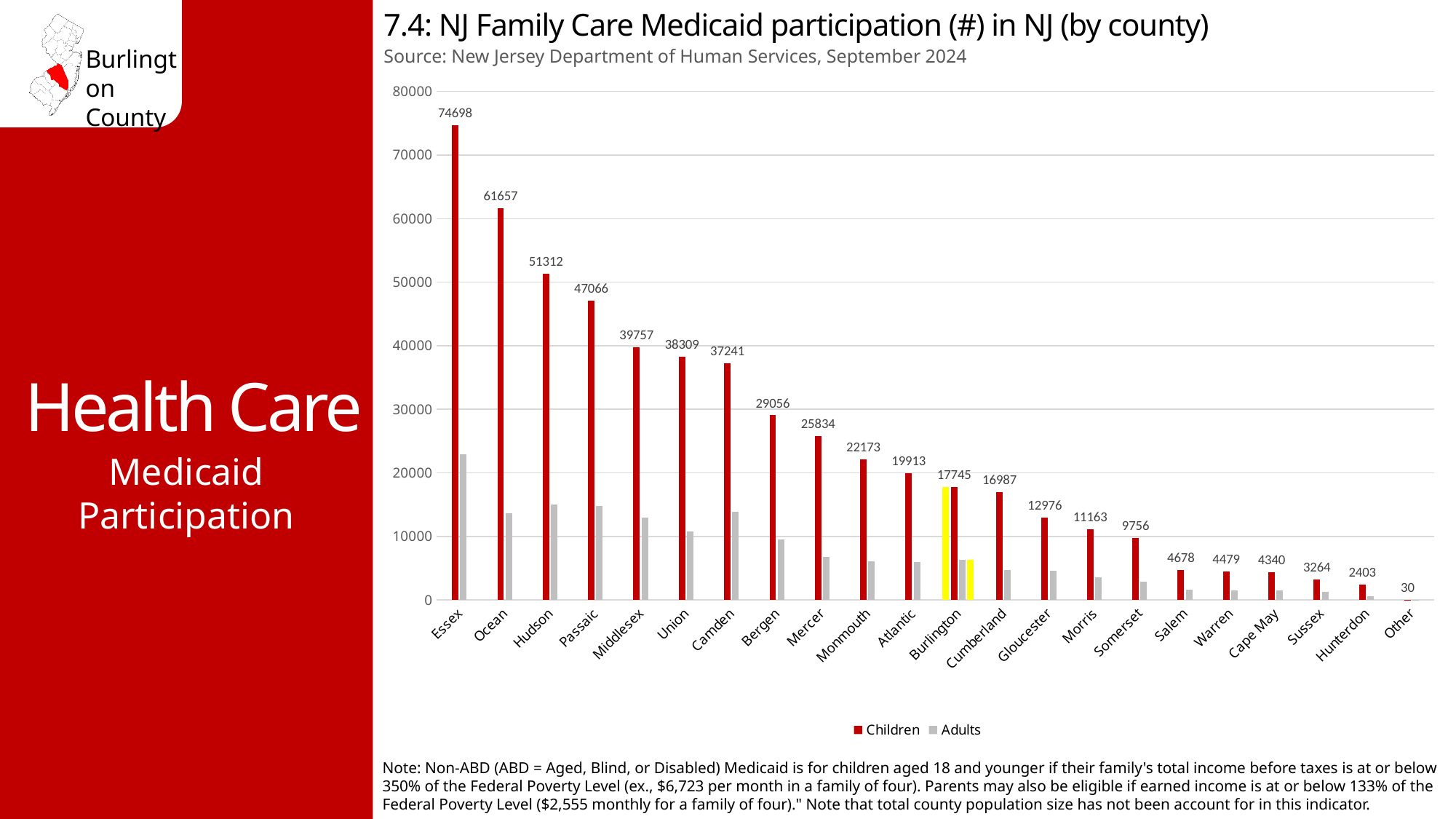
What is the Children value for Hunterdon? 2403 What is the Children value for Essex? 74698 What kind of chart is shown on the slide? Bar chart Is the Adults value for Essex greater or less than 20000? greater Which category has the lowest Children value? Other Is the Adults value for Morris greater or less than 10000? less Which has a larger Children value, Bergen or Mercer? Bergen Which county has the highest Children value? Essex What is the Children value for Burlington? 17745 What is the difference between the Children values for Ocean and Hudson? 10345 How many categories are shown on the x axis? 22 How many series does the legend list? 2